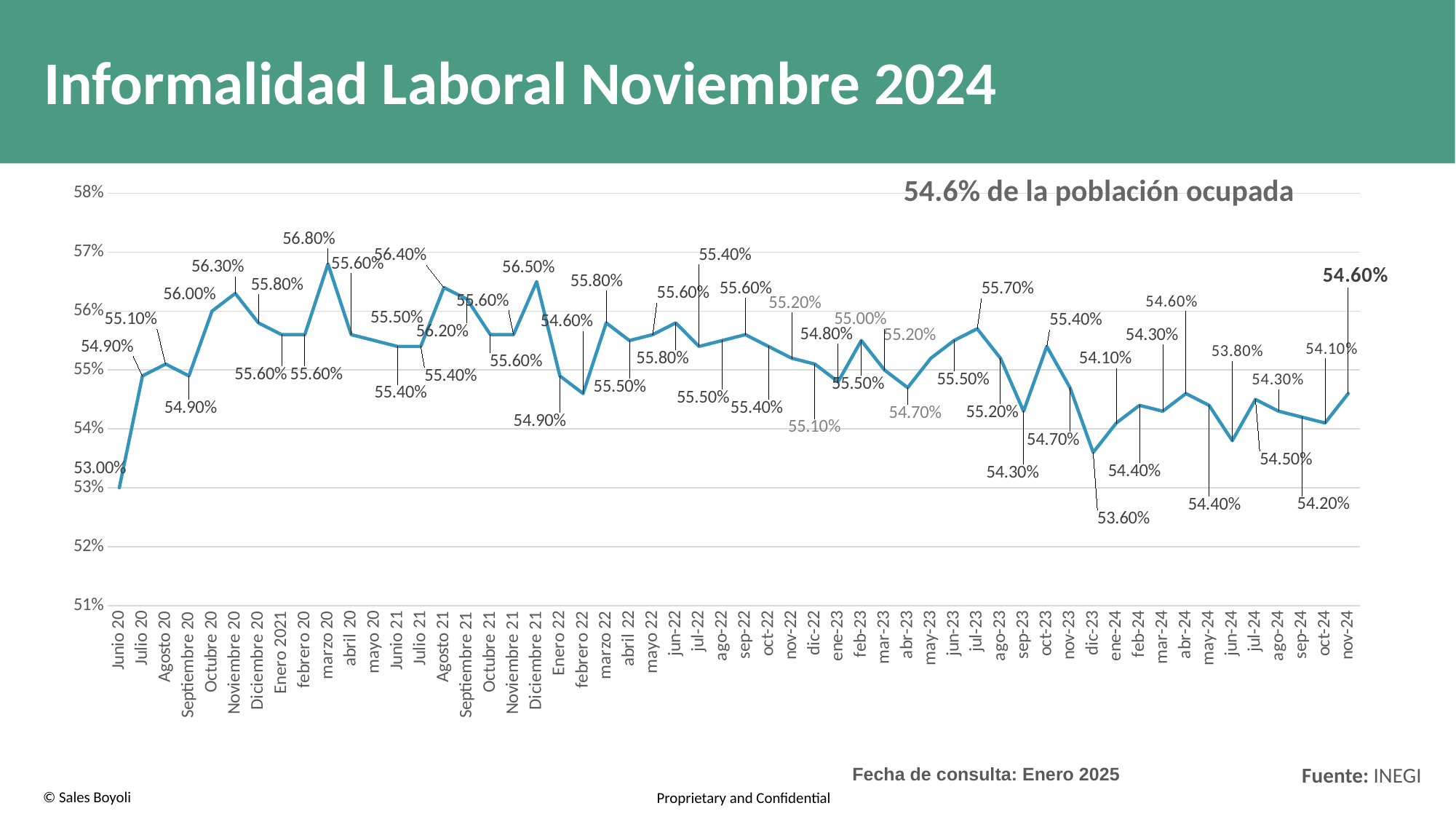
What is the value for dic-23? 53.60% How many monthly data points are plotted on the chart? 54 Which month has the lowest value on the chart? Junio 20 What is the value for nov-24? 54.60% What is the value for marzo 20 (the 2021 March point)? 56.80% What is the difference between the values for Noviembre 20 and Junio 20? 3.30% What is the difference between the values for nov-24 and oct-24? 0.50% Which month has the highest value on the chart? marzo 20 Is the value for dic-23 greater or less than 54%? less Do the values rise or fall from Junio 20 to Noviembre 20? rise Which is larger, the value for jul-23 or the value for sep-23? jul-23 What kind of chart is shown on the slide? line chart